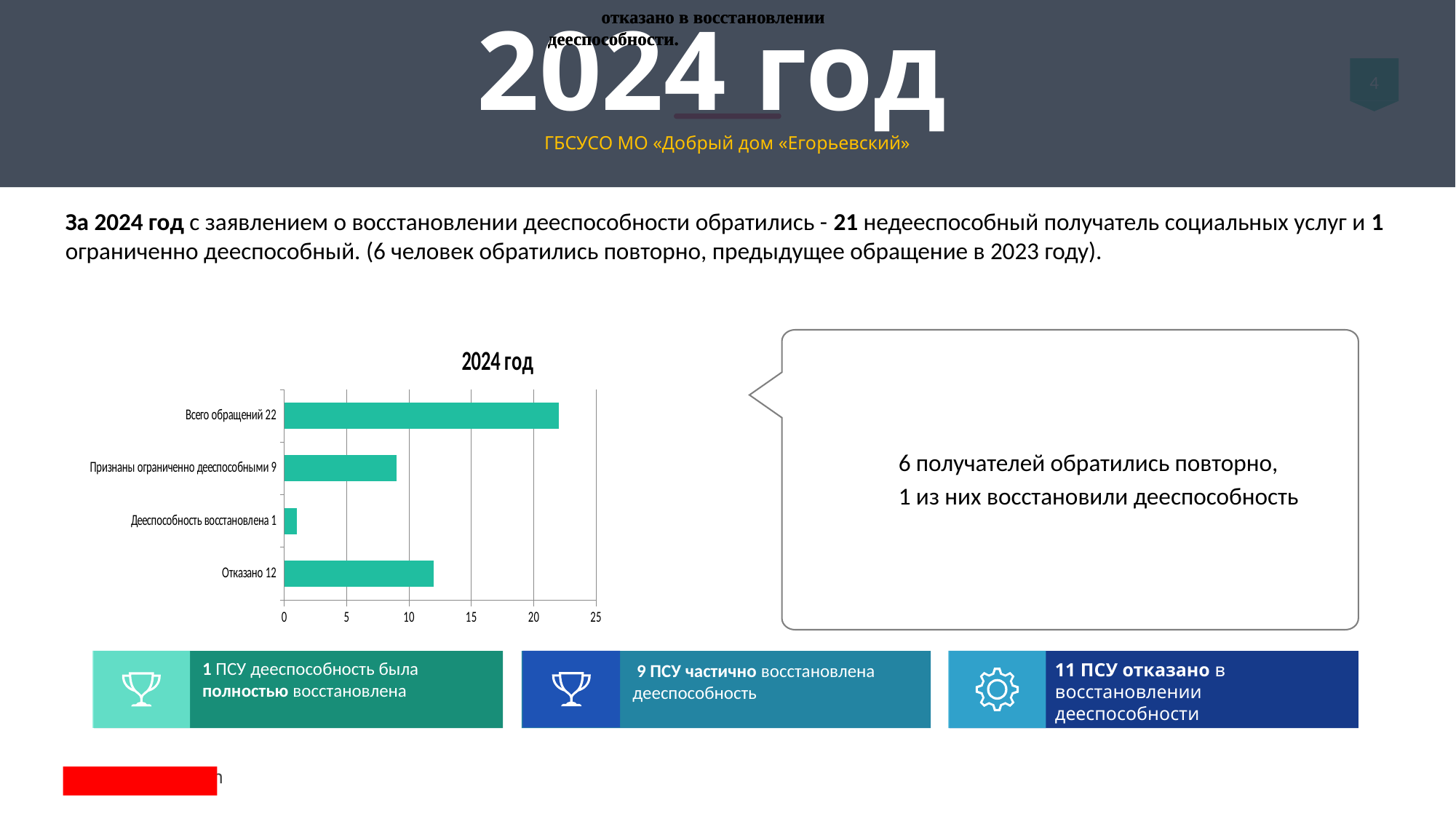
What is the value for "Признаны ограниченно дееспособными"? 9 Which is larger, "Отказано" or "Признаны ограниченно дееспособными"? Отказано What is the title of the chart? 2024 год What is the value for "Отказано"? 12 What is the value for "Дееспособность восстановлена"? 1 What type of chart is shown on the slide? bar chart How many categories (bars) does the chart show? 4 Which category has the lowest value? Дееспособность восстановлена Which category has the highest value? Всего обращений What is the value for "Всего обращений"? 22 What is the difference between "Отказано" and "Признаны ограниченно дееспособными"? 3 Is the value for "Всего обращений" greater or less than 20? greater